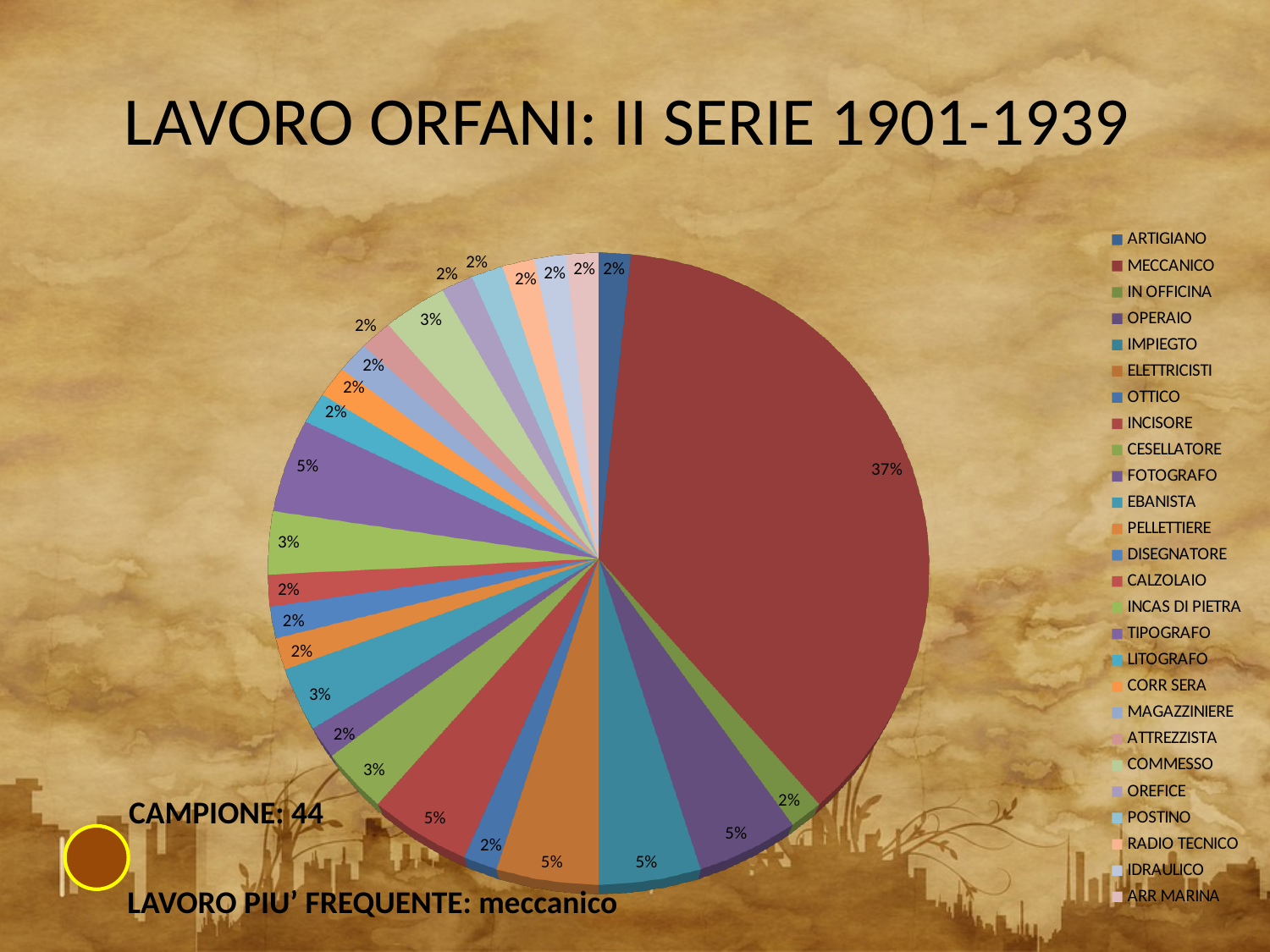
What percentage is shown for ARTIGIANO? 2% Which is larger, the slice for MECCANICO or the slice for ARTIGIANO? MECCANICO Which category has the largest slice of the pie? MECCANICO What is the difference in percentage points between MECCANICO and OPERAIO? 32 What share of the pie does MECCANICO represent? 37% How many categories does the legend list? 26 What is the title of the chart on the slide? LAVORO ORFANI: II SERIE 1901-1939 What percentage is shown for CESELLATORE? 3% What percentage is shown for IMPIEGTO? 5% What percentage is shown for OPERAIO? 5% What type of chart is shown on the slide? Pie chart What percentage is shown for ELETTRICISTI? 5%